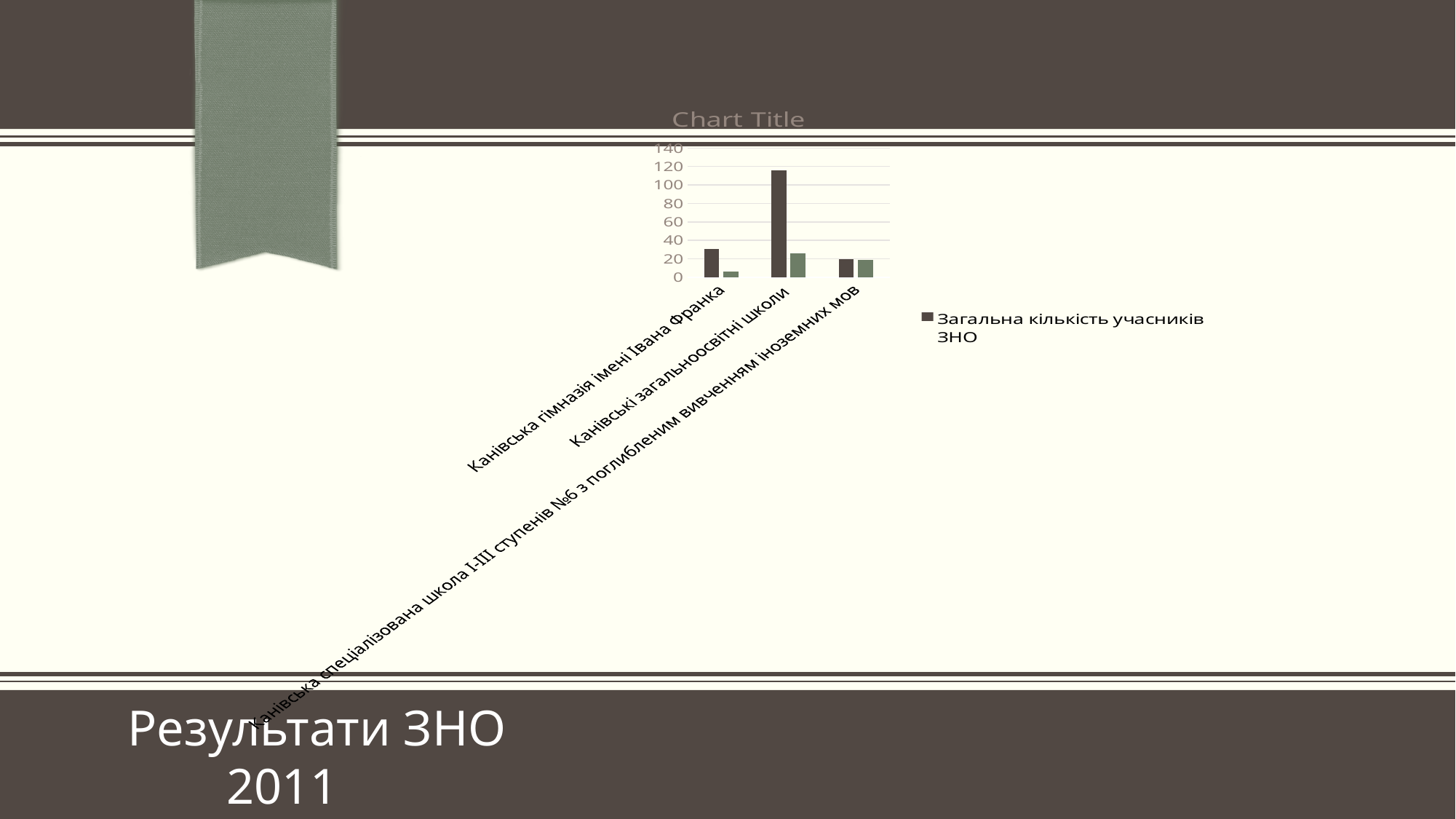
Which has the larger dark bar (Загальна кількість учасників ЗНО): Канівська гімназія імені Івана Франка or Канівська спеціалізована школа I-III ступенів №6 з поглибленим вивченням іноземних мов? Канівська гімназія імені Івана Франка What is the title shown above the chart? Chart Title What is the legend entry shown for the chart? Загальна кількість учасників ЗНО How many categories are shown on the x axis of the chart? 3 Which category has the tallest dark bar (Загальна кількість учасників ЗНО)? Канівські загальноосвітні школи For Канівська гімназія імені Івана Франка, which bar is taller: the dark bar or the green bar? the dark bar Which category has the shortest green bar? Канівська гімназія імені Івана Франка Is the green bar for Канівські загальноосвітні школи greater or less than 40? less Is the dark bar (Загальна кількість учасників ЗНО) for Канівські загальноосвітні школи greater or less than 100? greater What kind of chart is shown on the slide? bar chart How many series does the chart's legend list? 1 Is the dark bar (Загальна кількість учасників ЗНО) for Канівська гімназія імені Івана Франка greater or less than 40? less